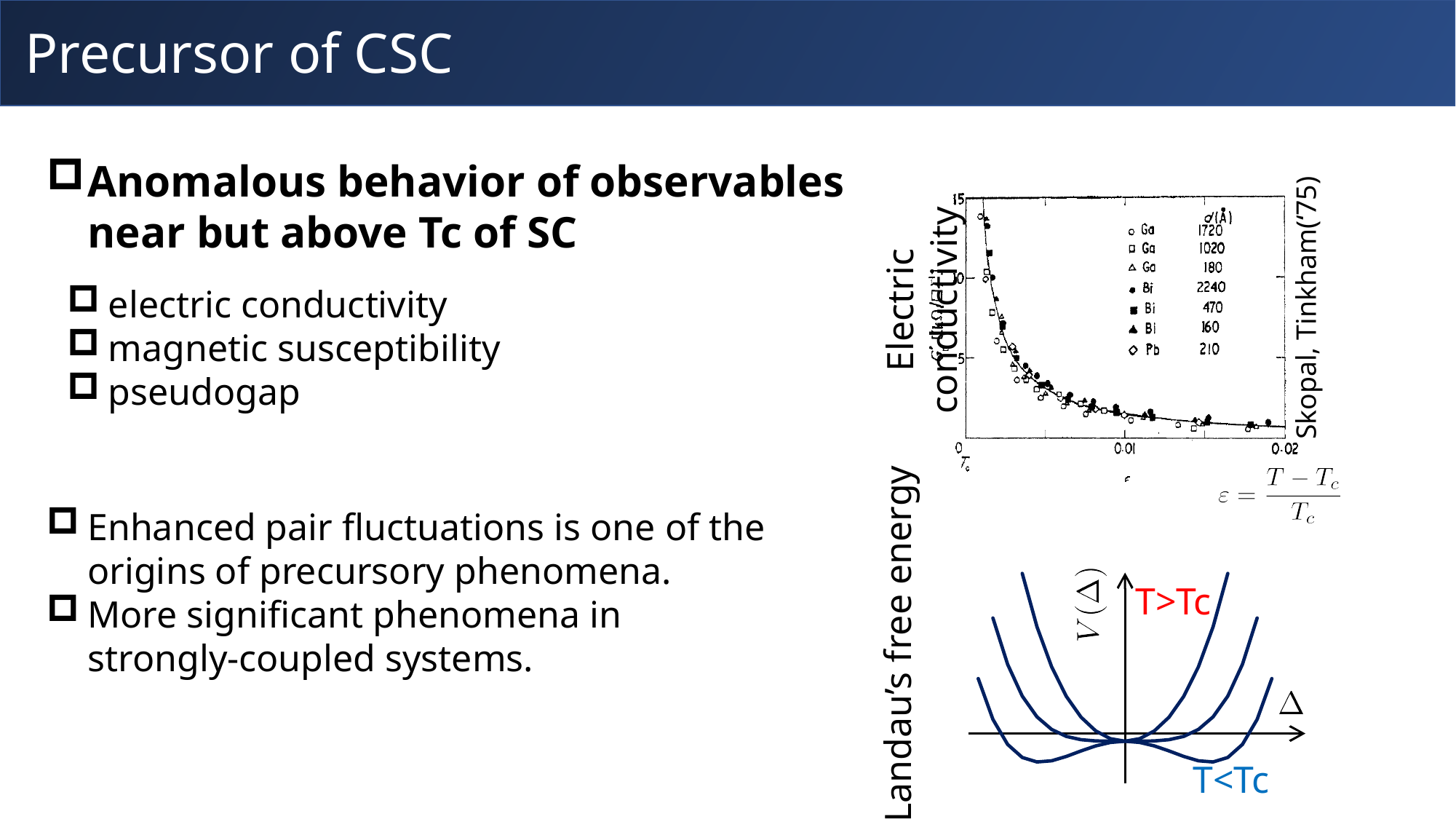
In the Landau's free energy chart, which temperature regime is labelled in red? T>Tc In the electric conductivity chart, which legend entry has the smallest d(Å) value? Bi 160 In the electric conductivity chart, what d(Å) value is listed for Pb in the legend? 210 In the electric conductivity chart, what is the highest tick value on the y axis? 15 In the electric conductivity chart, what kind of chart is it? scatter plot with a fitted curve In the electric conductivity chart, how many Ga entries are listed in the legend? 3 In the electric conductivity chart, do the plotted values rise or fall as ε increases? fall In the electric conductivity chart, what is the difference between the d(Å) values of the two Bi entries 2240 and 470? 1770 In the electric conductivity chart, what is the largest value shown on the x axis? 0.02 In the electric conductivity chart, how many entries does the legend list? 7 In the electric conductivity chart, which legend entry has the largest d(Å) value? Bi 2240